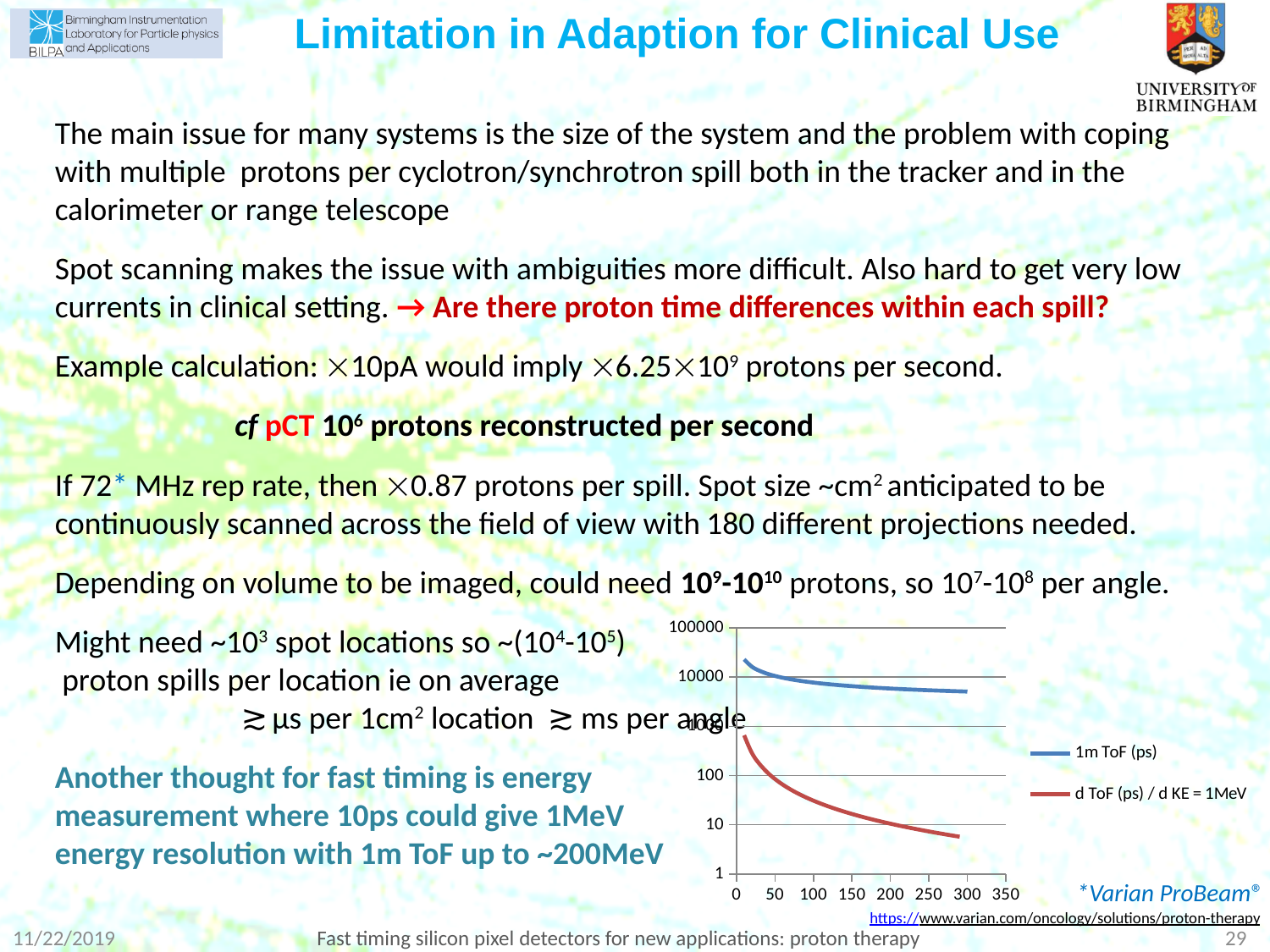
Is the value of the '1m ToF (ps)' series at x = 300 greater or less than 10000? less What kind of chart is shown on the slide? line chart How many series does the chart legend list? 2 Is the value of the 'd ToF (ps) / d KE = 1MeV' series at x = 100 greater or less than 100? less Is the value of the 'd ToF (ps) / d KE = 1MeV' series at x = 10 greater or less than 100? greater Which colour is used for the '1m ToF (ps)' series in the chart? blue Does the 'd ToF (ps) / d KE = 1MeV' series rise or fall as the x-axis value increases? fall Does the '1m ToF (ps)' series rise or fall as the x-axis value increases? fall What is the highest tick value shown on the chart's y-axis? 100000 What are the two series named in the chart legend? 1m ToF (ps) and d ToF (ps) / d KE = 1MeV At x = 300, which series has the larger value, '1m ToF (ps)' or 'd ToF (ps) / d KE = 1MeV'? 1m ToF (ps)